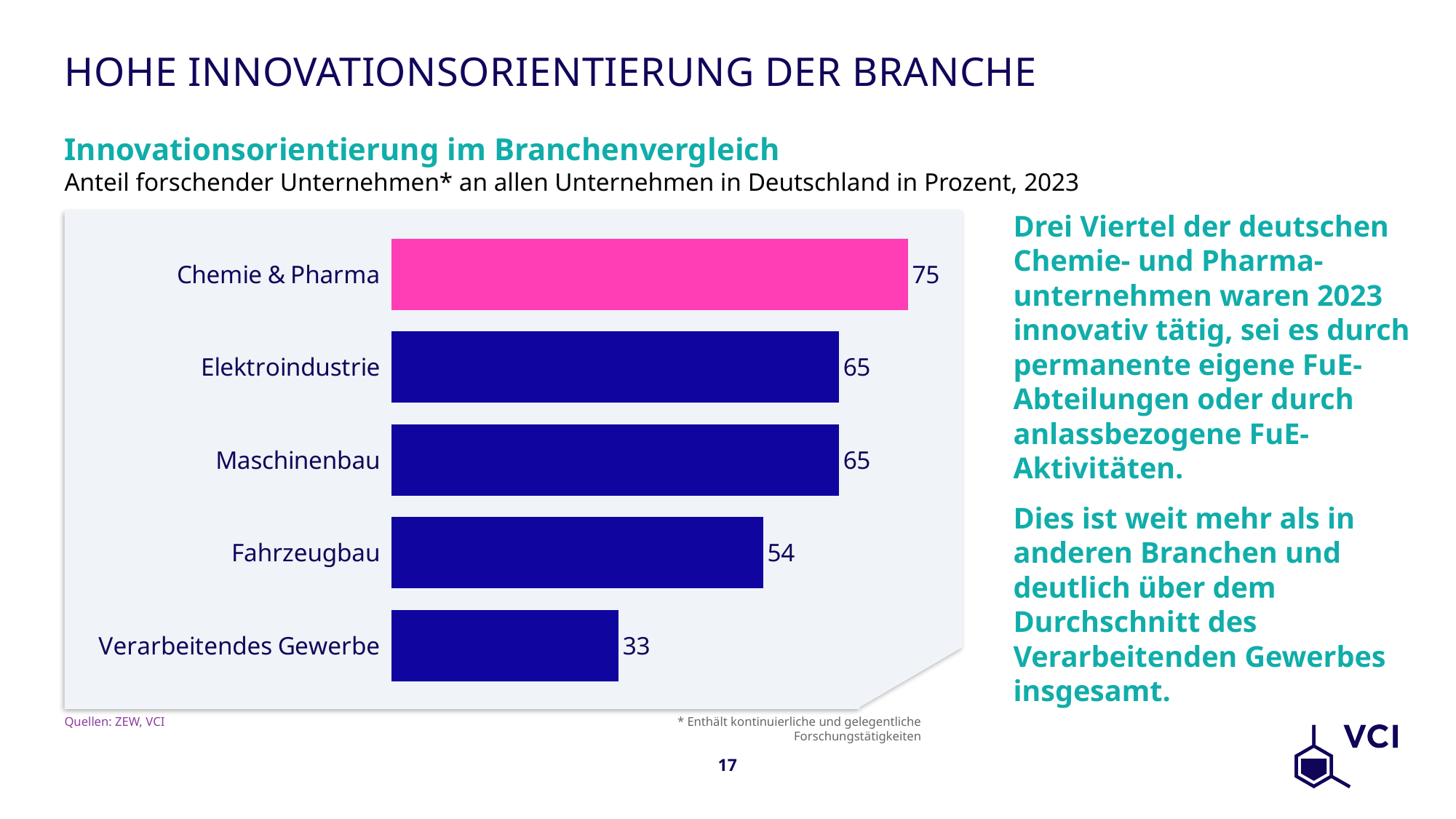
What is the value for Chemie & Pharma? 75 Which bar is coloured pink rather than dark blue? Chemie & Pharma How many categories are shown in the chart? 5 What is the value for Verarbeitendes Gewerbe? 33 Which is larger, the value for Fahrzeugbau or the value for Maschinenbau? Maschinenbau What is the difference between the values for Chemie & Pharma and Maschinenbau? 10 What kind of chart is shown on the slide? Bar chart What is the value for Elektroindustrie? 65 Which category has the lowest value? Verarbeitendes Gewerbe Which category has the highest value? Chemie & Pharma What is the difference between the values for Chemie & Pharma and Verarbeitendes Gewerbe? 42 What is the value for Fahrzeugbau? 54